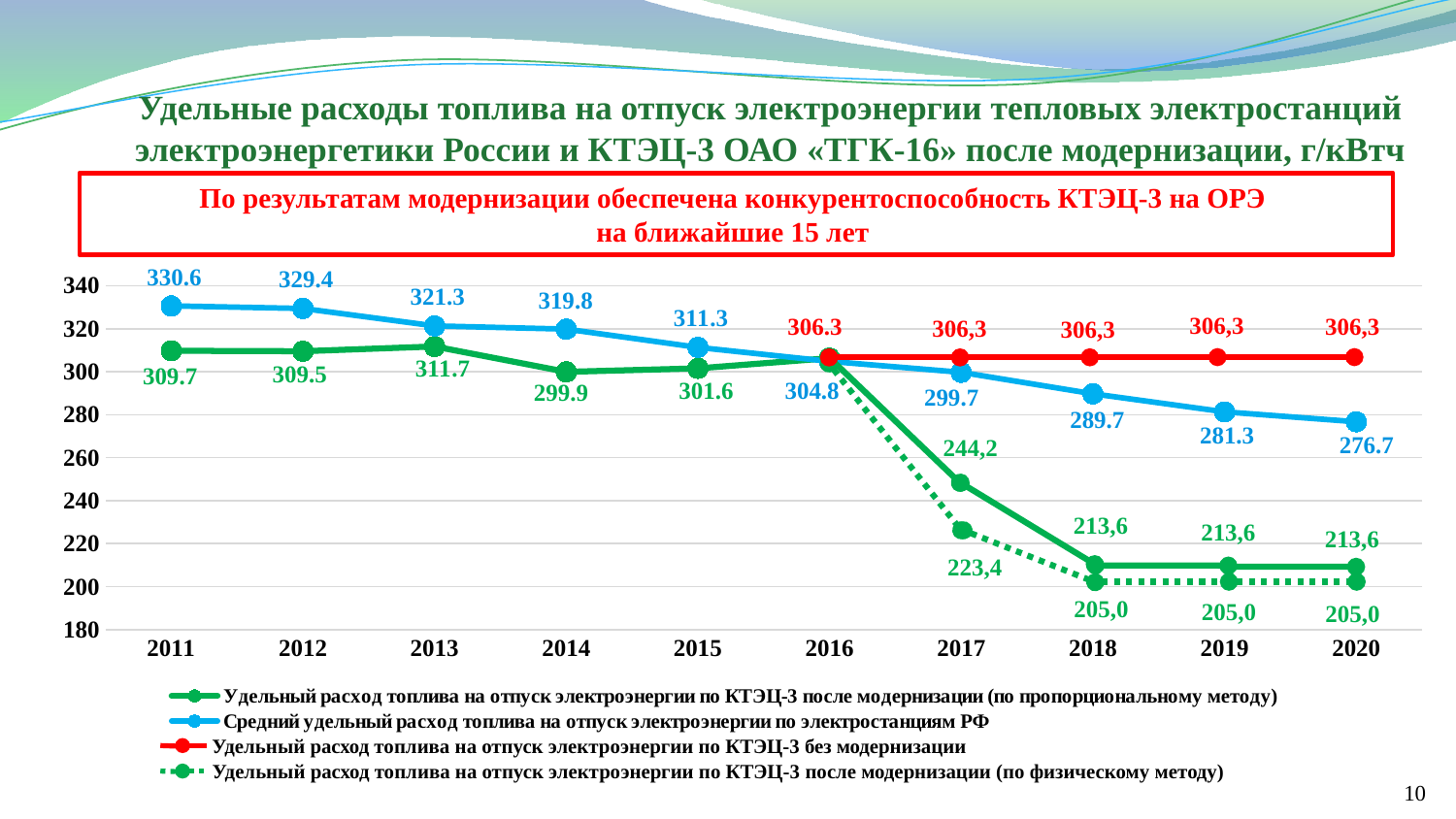
What is the value for KTEC-3 after modernization (proportional method, solid green line) in 2017? 244,2 What is the value for KTEC-3 after modernization by the physical method (dotted green line) in 2018? 205,0 What is the value of the blue series (average for RF power plants) in 2020? 276.7 How many series does the legend list? 4 How many years are shown on the x axis? 10 In 2020, which is larger: the value for KTEC-3 without modernization (red) or the average for RF power plants (blue)? KTEC-3 without modernization (red) What kind of chart is shown on the slide? line chart Does the blue series (average for RF power plants) rise or fall from 2011 to 2020? fall What is the value for KTEC-3 without modernization (red series) in 2020? 306,3 By how much does the blue series (average for RF power plants) decrease from 2011 to 2020? 53.9 In which year is the blue series (average for RF power plants) at its lowest? 2020 What is the average specific fuel consumption for power plants of the Russian Federation (blue series) in 2011? 330.6